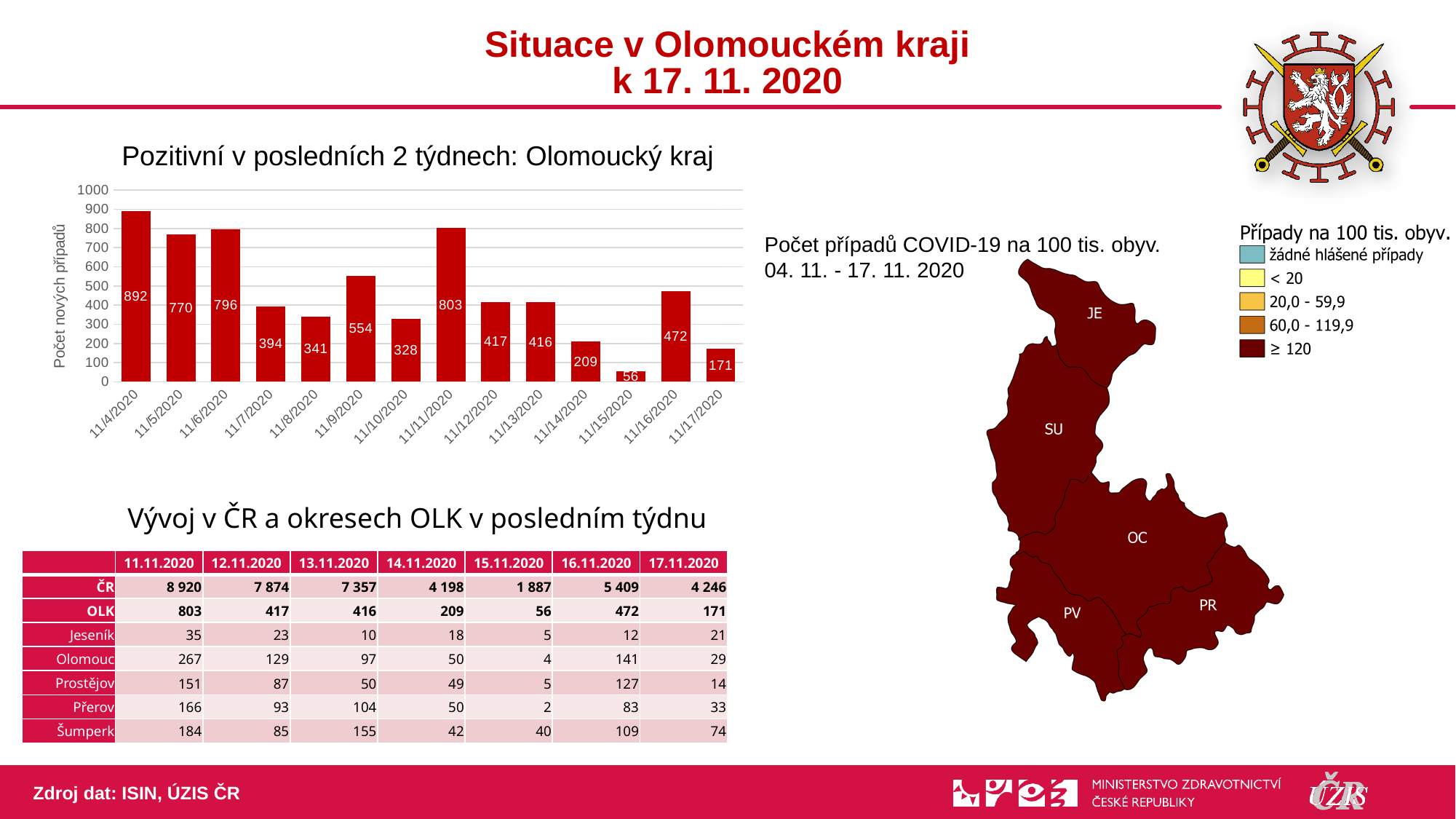
What is the y-axis title of the bar chart? Počet nových případů What is the difference between the values for 11/4/2020 and 11/15/2020 in the bar chart? 836 What is the value for 11/11/2020 in the bar chart? 803 What kind of chart is 'Pozitivní v posledních 2 týdnech: Olomoucký kraj'? bar chart Which is larger in the bar chart: the value for 11/6/2020 or 11/5/2020? 11/6/2020 What is the value for 11/4/2020 in the chart 'Pozitivní v posledních 2 týdnech: Olomoucký kraj'? 892 Is the value for 11/9/2020 in the bar chart greater or less than 500? greater What is the difference between the values for 11/9/2020 and 11/8/2020 in the bar chart? 213 What is the value for 11/16/2020 in the bar chart? 472 Which date has the lowest value in the bar chart? 11/15/2020 How many dates (bars) are shown in the bar chart? 14 Which date has the highest value in the bar chart? 11/4/2020